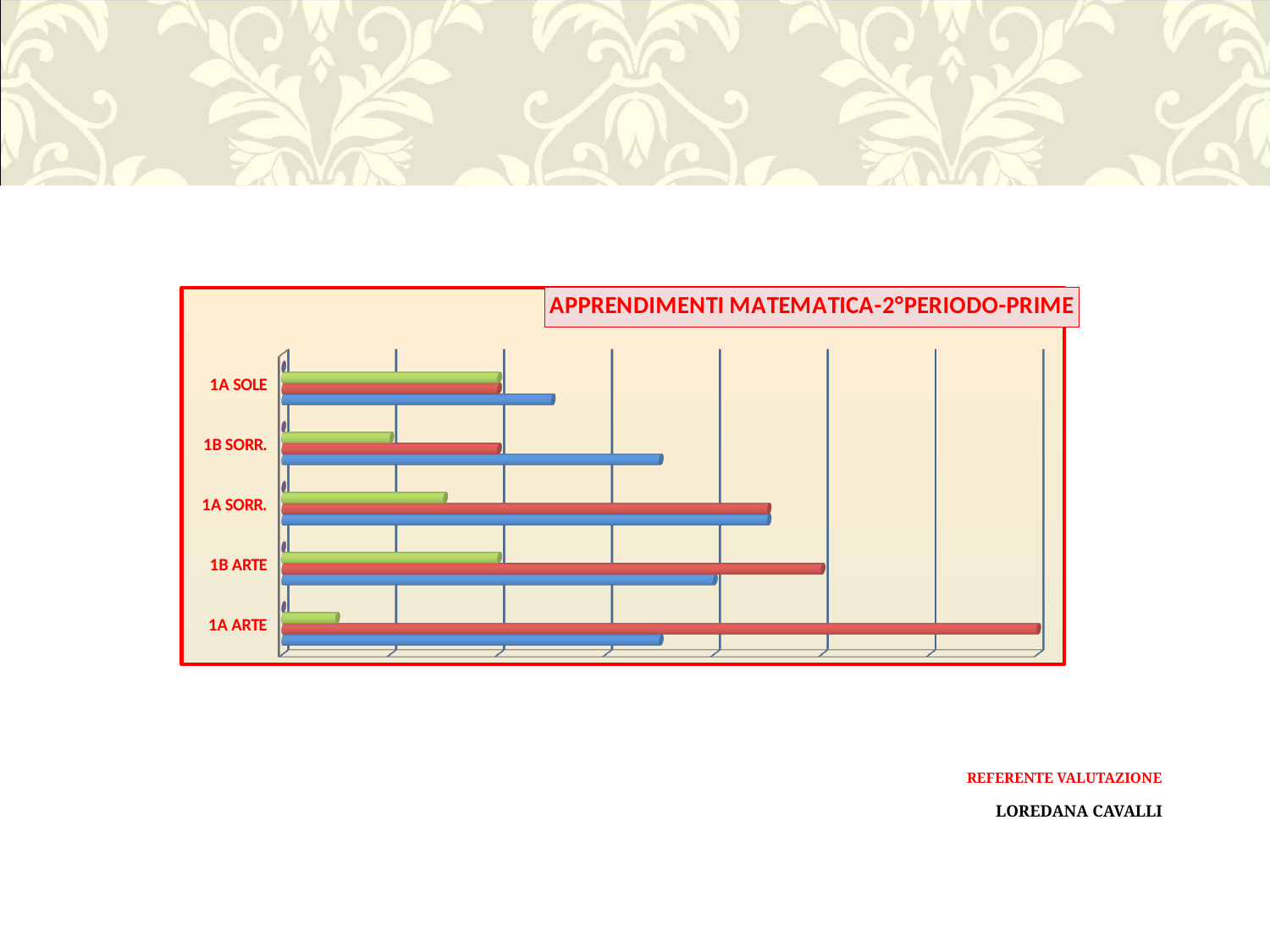
Which category has the shortest blue bar? 1A SOLE Which category has the longest blue bar? 1A SORR. How many categories (classes) are listed on the vertical axis of the chart? 5 Which category appears at the top of the vertical axis? 1A SOLE For 1A ARTE, which bar is longer, the red one or the blue one? the red one What kind of chart is shown on the slide? bar chart Which category has the longest red bar? 1A ARTE What is the title of the chart? APPRENDIMENTI MATEMATICA-2°PERIODO-PRIME For 1B SORR., which bar is longer, the blue one or the red one? the blue one How many bars are shown for each category in the chart? 3 Which category has the shortest green bar? 1A ARTE For 1A SOLE, which bar is longer, the blue one or the green one? the blue one